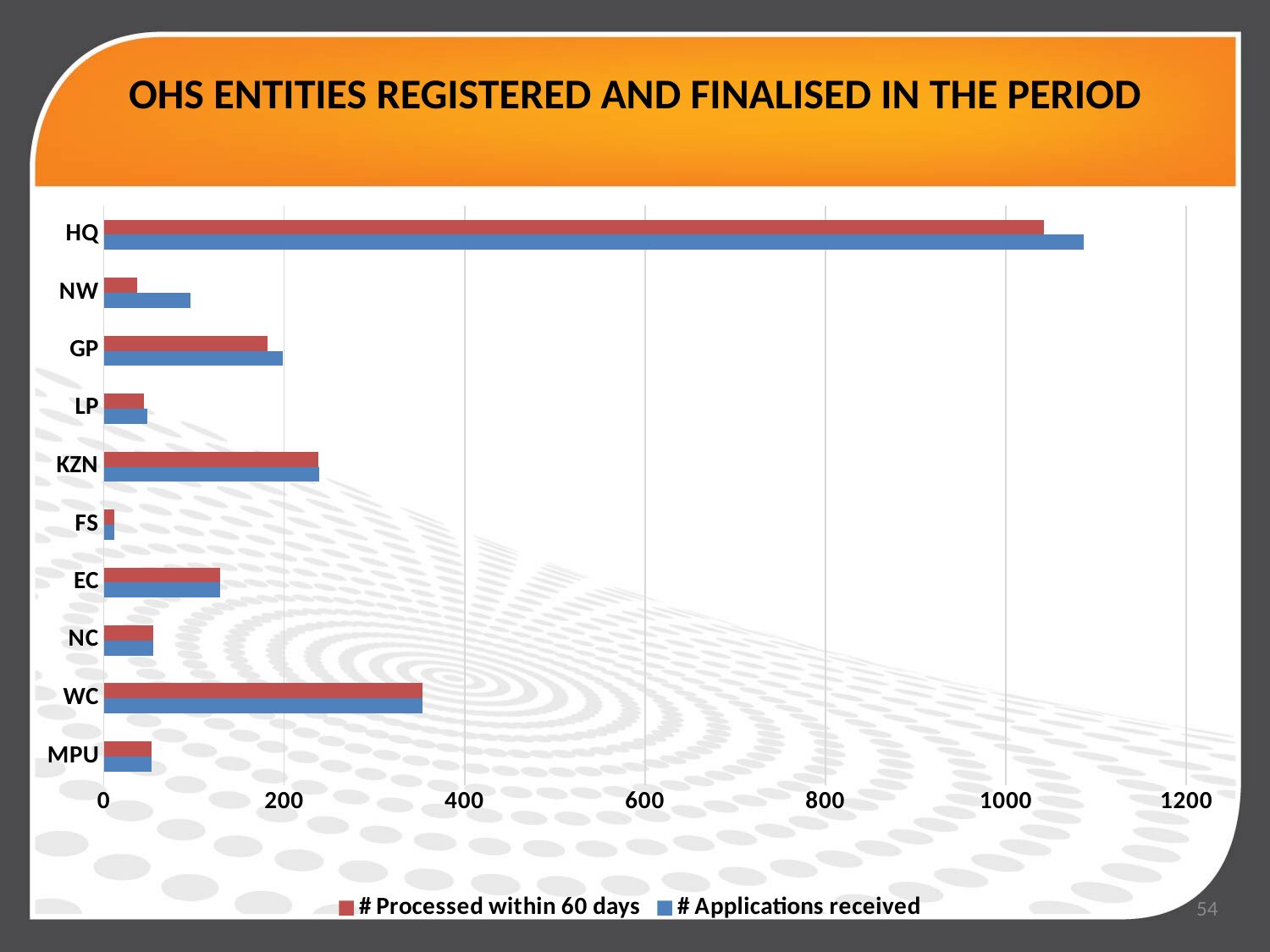
How many categories (offices) are shown on the chart? 10 Which office has more applications received, WC or KZN? WC What is the title of the chart? OHS ENTITIES REGISTERED AND FINALISED IN THE PERIOD Is the number of applications received for WC greater or less than 400? less Which office has the lowest number of applications received? FS Is the number of applications received for KZN greater or less than 200? greater How many series does the legend list? 2 What type of chart is shown on the slide? bar chart Which office has the highest number of applications received? HQ Is the number of applications received for NW greater or less than 200? less For NW, which is larger: the number processed within 60 days or the number of applications received? # Applications received